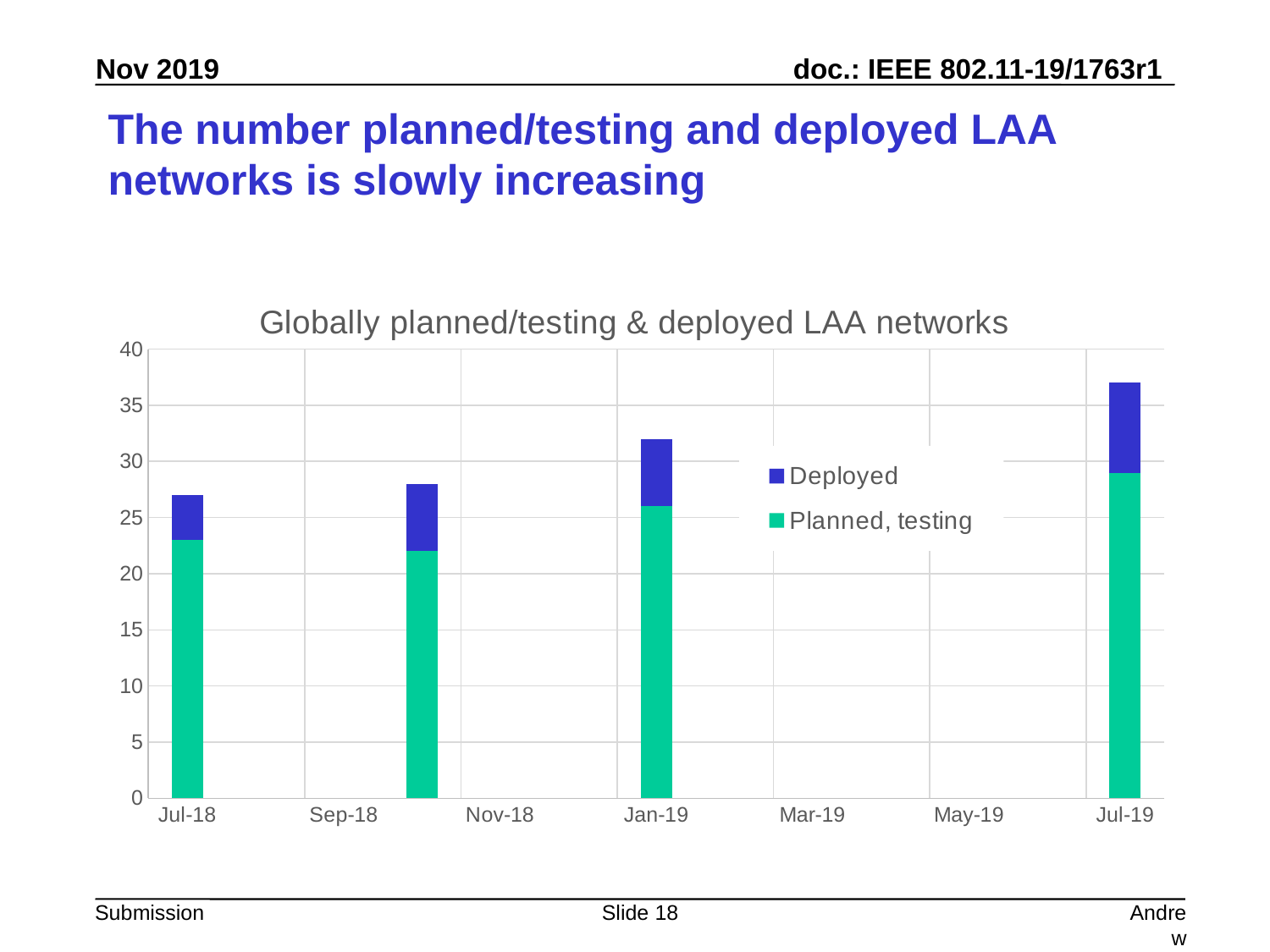
Which bar has the highest total? Jul-19 Is the total for Jul-18 greater or less than 30? less How many bars are plotted in the chart? 4 Do the bar totals rise or fall from Jul-18 to Jul-19? Rise Is the total for Jul-19 greater or less than 35? greater Is the total for Jan-19 greater or less than 30? greater What is the title of the chart? Globally planned/testing & deployed LAA networks How many series does the legend list? 2 What are the two series named in the legend? Deployed; Planned, testing What kind of chart is shown on the slide? Stacked bar chart Which has the larger total, Jan-19 or Jul-19? Jul-19